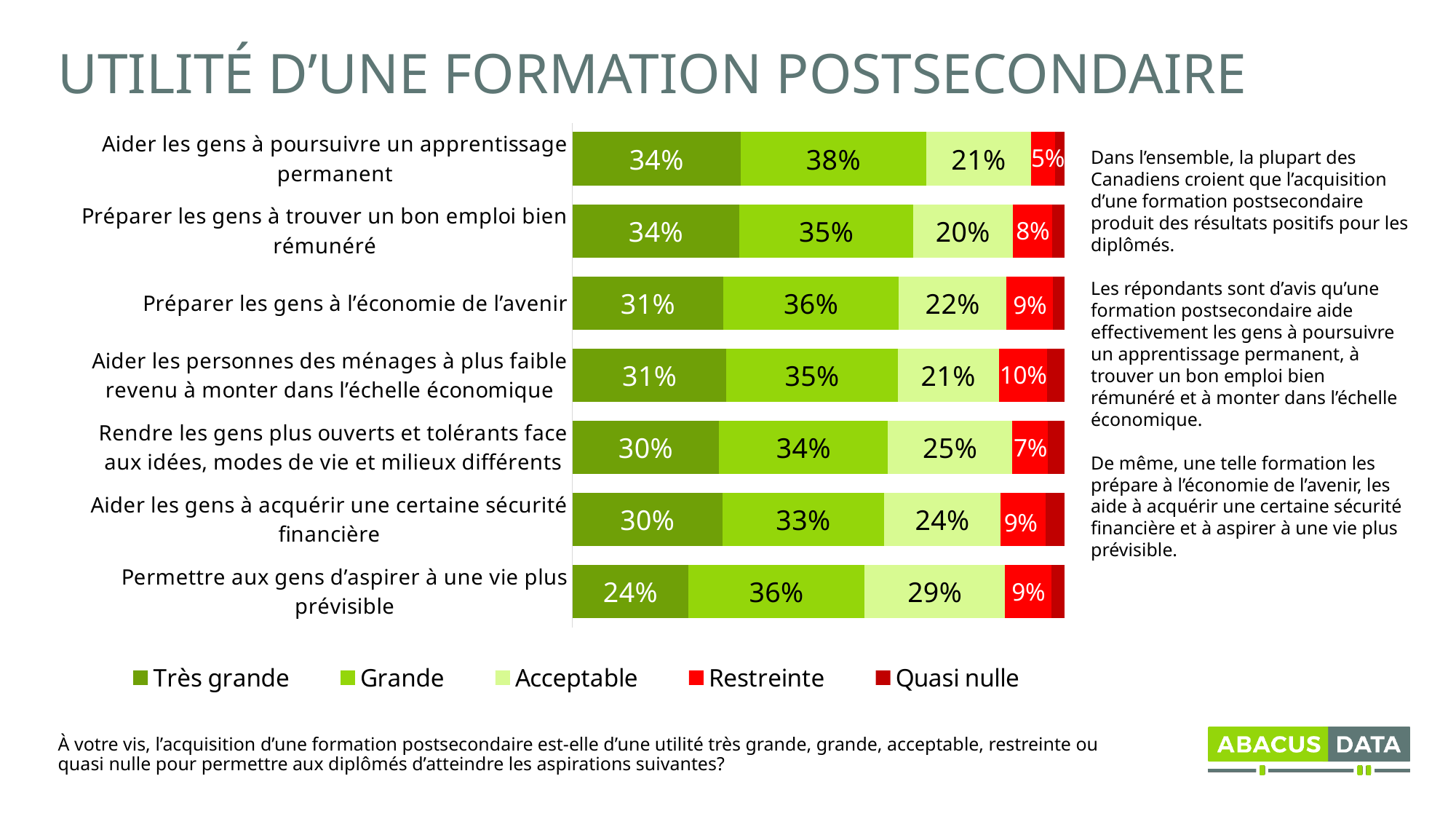
What is the "Acceptable" value for "Permettre aux gens d'aspirer à une vie plus prévisible"? 29% What percentage of respondents rated the usefulness as "Très grande" for "Préparer les gens à l'économie de l'avenir"? 31% Which has a larger "Acceptable" value: "Rendre les gens plus ouverts et tolérants face aux idées, modes de vie et milieux différents" or "Préparer les gens à l'économie de l'avenir"? Rendre les gens plus ouverts et tolérants face aux idées, modes de vie et milieux différents Which category has the lowest "Restreinte" value? Aider les gens à poursuivre un apprentissage permanent What is the difference in percentage points between the "Grande" value for "Aider les gens à poursuivre un apprentissage permanent" and the "Grande" value for "Aider les gens à acquérir une certaine sécurité financière"? 5 percentage points How many categories (aspirations) are shown in the chart? 7 Which category has the highest "Acceptable" value? Permettre aux gens d'aspirer à une vie plus prévisible What is the "Restreinte" value for "Aider les personnes des ménages à plus faible revenu à monter dans l'échelle économique"? 10% What colour represents "Restreinte" in the legend? Red What kind of chart is shown on the slide? Stacked bar chart Which category has the lowest "Très grande" value? Permettre aux gens d'aspirer à une vie plus prévisible How many series does the legend list? 5